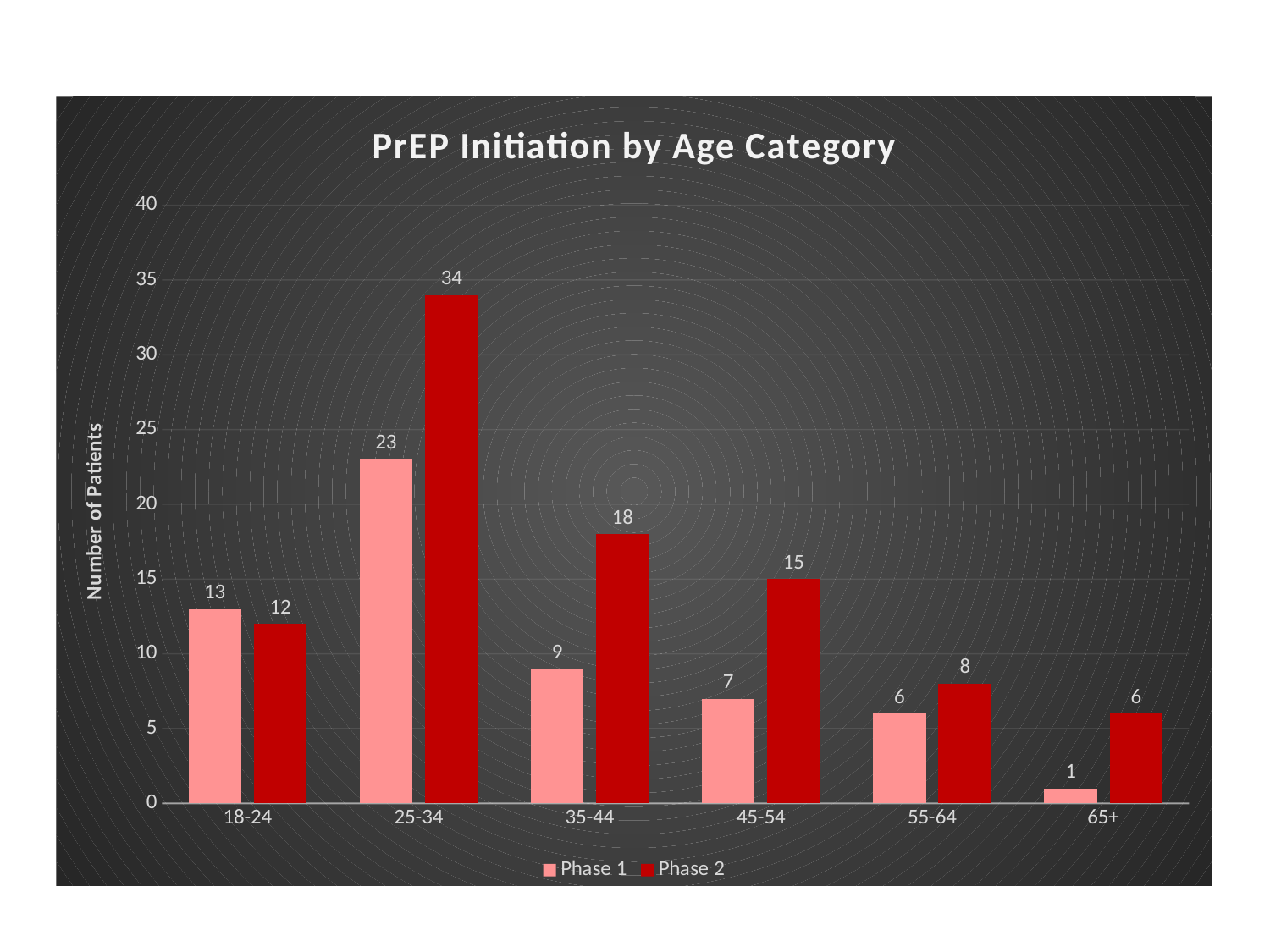
What kind of chart is shown on the slide? Bar chart How many series does the legend list? 2 What is the Phase 1 value for the 65+ age category? 1 What is the difference between the Phase 2 and Phase 1 values for the 25-34 age category? 11 How many age categories are shown on the x axis? 6 What is the title of the chart? PrEP Initiation by Age Category Which age category has the lowest Phase 2 value? 65+ Which is larger for the 18-24 age category, Phase 1 or Phase 2? Phase 1 What is the Phase 1 value for the 45-54 age category? 7 Is the Phase 2 value for 35-44 greater or less than 15? greater Which age category has the highest Phase 1 value? 25-34 What is the Phase 2 value for the 25-34 age category? 34